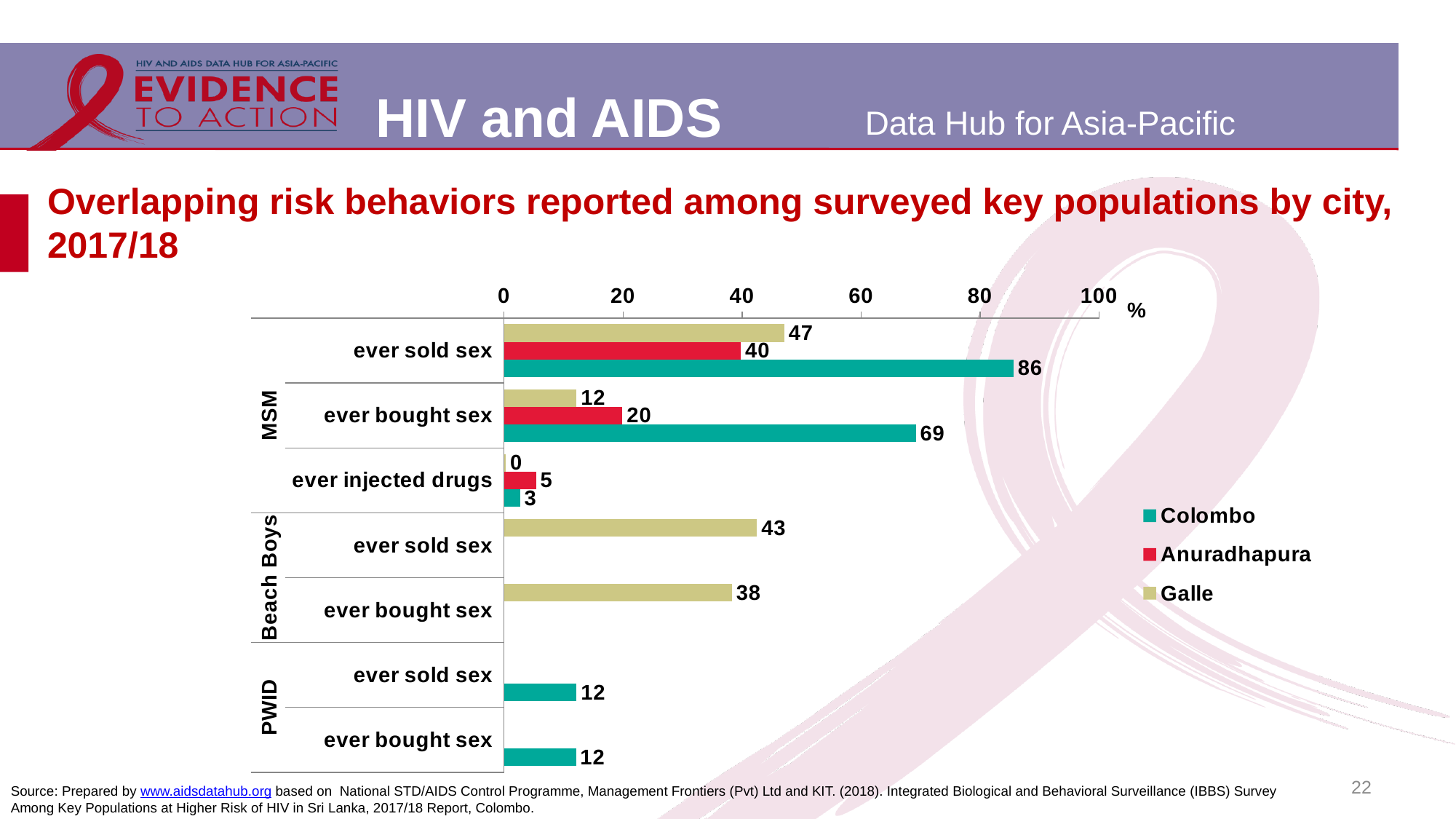
What percentage of MSM in Anuradhapura reported having ever injected drugs? 5 What percentage of MSM in Colombo reported having ever sold sex? 86 What type of chart is shown on the slide? Bar chart What percentage of Beach Boys in Galle reported having ever sold sex? 43 For MSM who ever sold sex, which is larger: the Galle value or the Anuradhapura value? Galle What is the difference between the Colombo and Anuradhapura values for MSM who ever bought sex? 49 Which city has the highest percentage of MSM who ever sold sex? Colombo What percentage of PWID in Colombo reported having ever bought sex? 12 Which city has the lowest percentage of MSM who ever injected drugs? Galle What percentage of MSM in Galle reported having ever bought sex? 12 How many series does the legend list? 3 Which colour represents Anuradhapura in the chart? Red